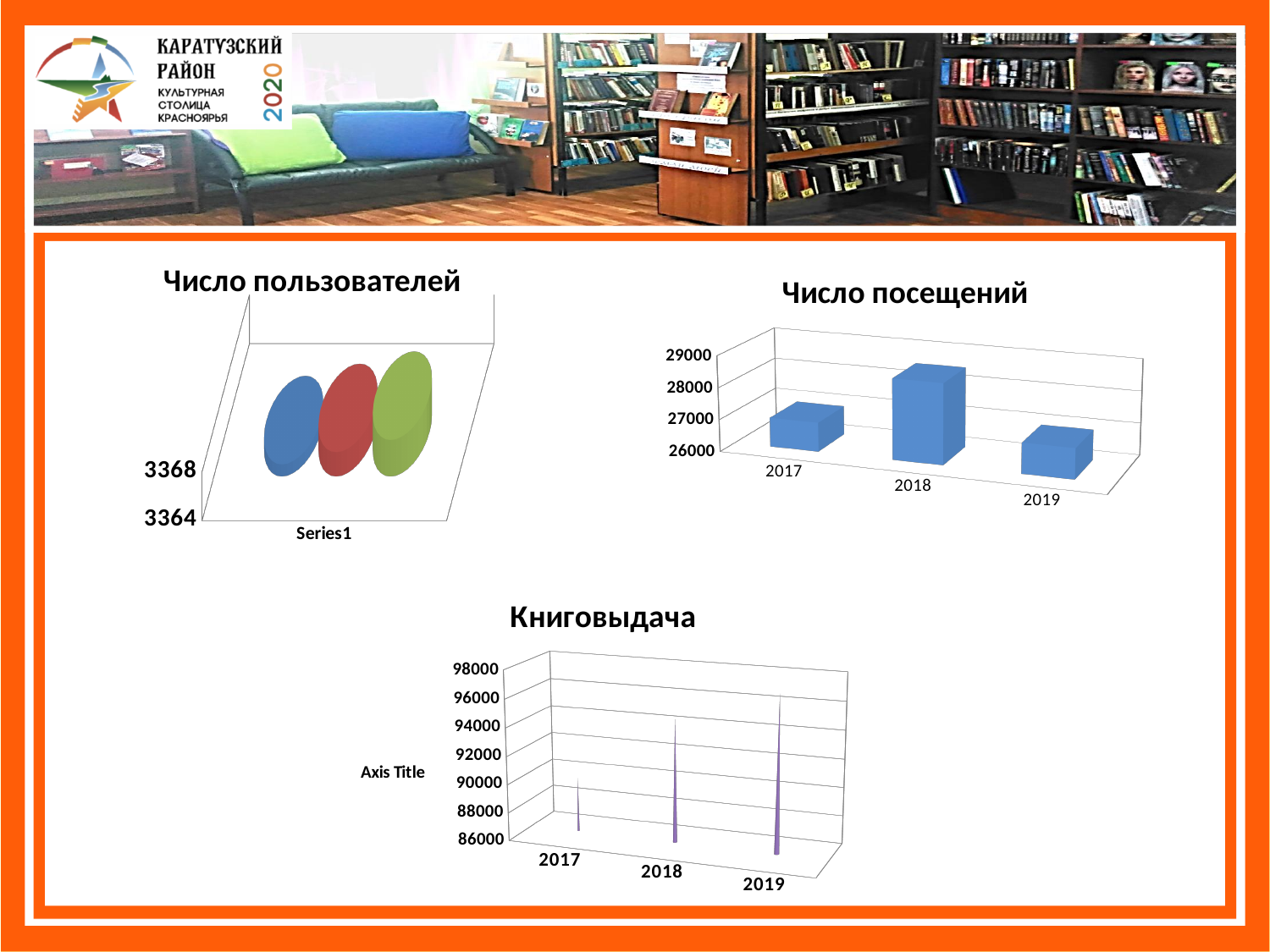
In the chart titled 'Книговыдача', is the value for 2018 greater or less than 92000? greater In the chart titled 'Книговыдача', is the value for 2017 greater or less than 92000? less In the chart titled 'Книговыдача', do the values rise or fall from 2017 to 2019? rise In the chart titled 'Число посещений', how many years are shown on the x axis? 3 In the chart titled 'Число посещений', which year has the highest value? 2018 In the chart titled 'Книговыдача', which year has the highest value? 2019 In the chart titled 'Книговыдача', which year has the lowest value? 2017 In the chart titled 'Число посещений', is the value for 2018 greater or less than 28000? greater What is the title of the chart in the top-left of the slide? Число пользователей